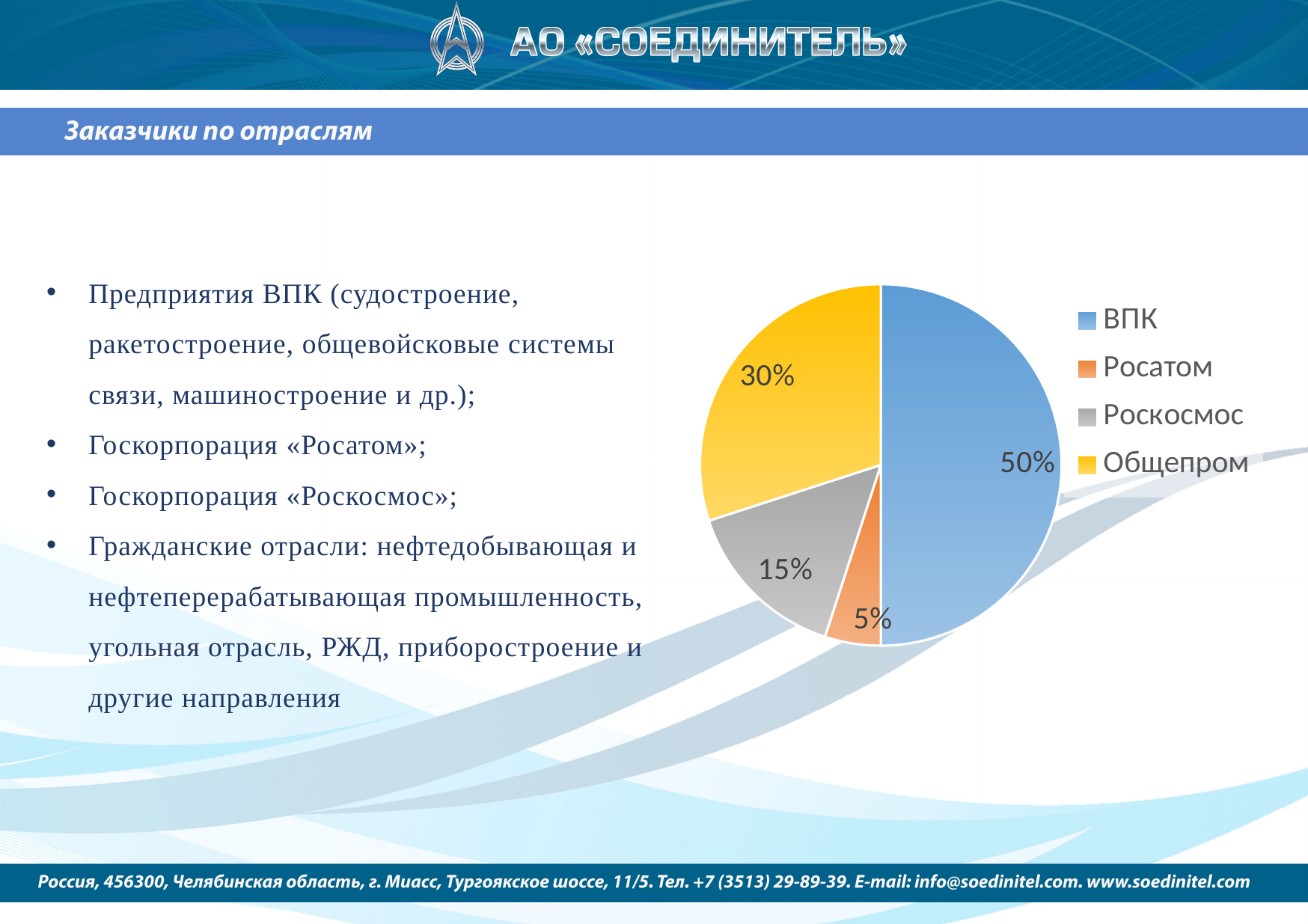
What share of the pie chart does ВПК account for? 50% What is the combined share of Росатом and Роскосмос in the pie chart? 20% What type of chart is shown on the slide? Pie chart Which category has the smallest slice of the pie chart? Росатом What share of the pie chart does Роскосмос account for? 15% Which category has the largest slice of the pie chart? ВПК What is the difference in percentage points between the ВПК slice and the Общепром slice? 20% What share of the pie chart does Росатом account for? 5% What colour is the Общепром slice in the pie chart? Yellow What share of the pie chart does Общепром account for? 30% How many categories are shown in the pie chart? 4 Which slice is larger, Роскосмос or Общепром? Общепром